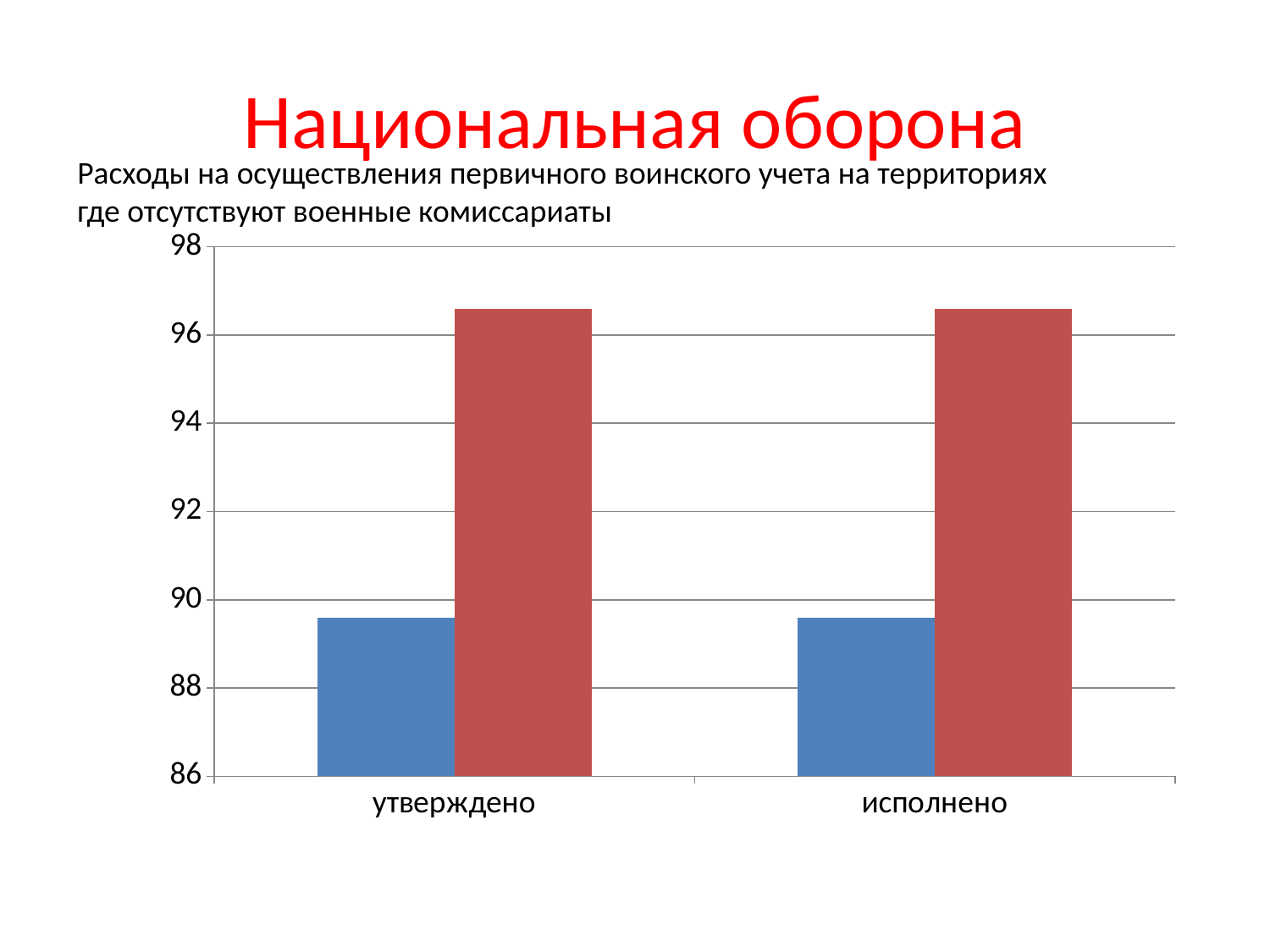
How many categories are shown on the x axis of the chart? 2 What kind of chart is shown on the slide? bar chart For the category утверждено, which bar is taller, the blue one or the red one? the red one What is the highest value shown on the y axis of the chart? 98 Is the value of the red bar for утверждено greater or less than 96? greater For the category исполнено, which bar is shorter, the blue one or the red one? the blue one Is the value of the blue bar for исполнено greater or less than 88? greater What are the two category labels on the x axis of the chart? утверждено, исполнено Is the value of the red bar for исполнено greater or less than 98? less How many bars are plotted in the chart in total? 4